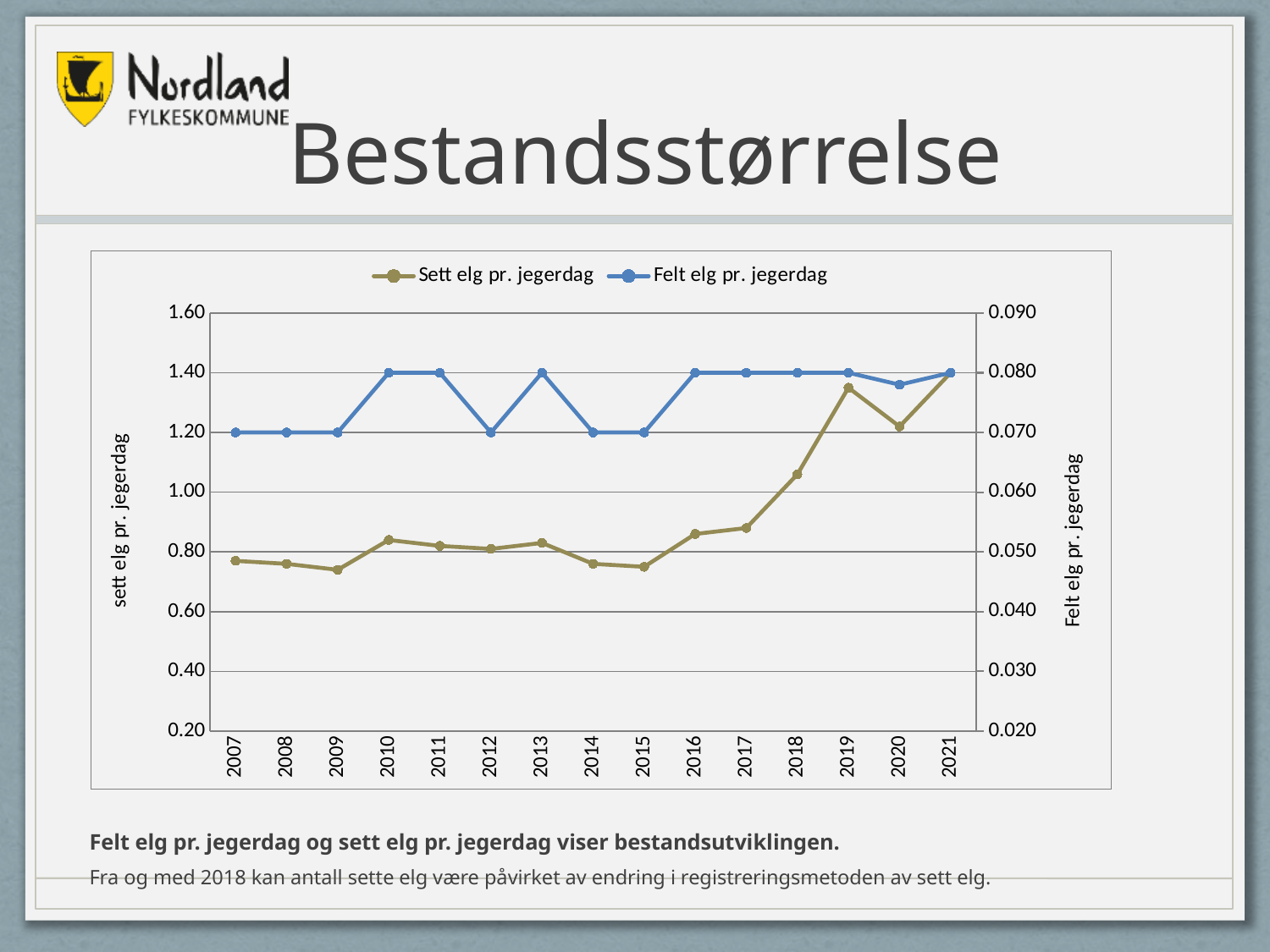
Which year has the larger value for Sett elg pr. jegerdag, 2017 or 2018? 2018 How many years are shown on the x axis? 15 What kind of chart is shown on the slide? line chart Is the value for Sett elg pr. jegerdag in 2009 greater or less than 0.80? less Is the value for Sett elg pr. jegerdag in 2019 greater or less than 1.20? greater In which year is Sett elg pr. jegerdag highest? 2021 How many series does the legend list? 2 Is the value for Sett elg pr. jegerdag in 2018 greater or less than 1.00? greater Does Sett elg pr. jegerdag rise or fall from 2015 to 2019? rise What is the value of Felt elg pr. jegerdag in 2012? 0.070 What is the value of Felt elg pr. jegerdag in 2007? 0.070 What is the value of Felt elg pr. jegerdag in 2010? 0.080